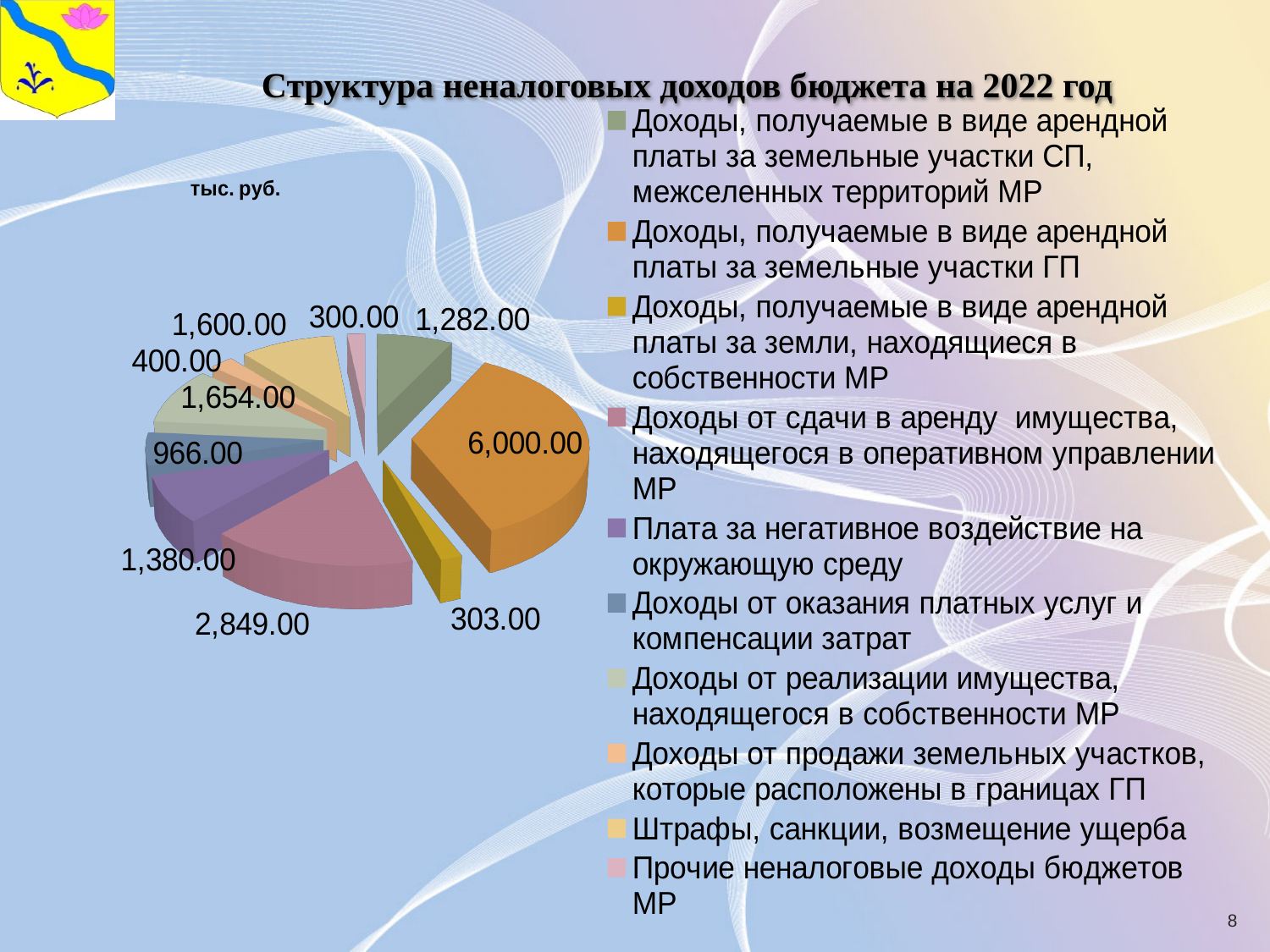
What is the title of the chart on the slide? Структура неналоговых доходов бюджета на 2022 год Which is larger: the value for 'Доходы от реализации имущества, находящегося в собственности МР' or the value for 'Доходы от оказания платных услуг и компенсации затрат'? Доходы от реализации имущества, находящегося в собственности МР What kind of chart is shown on the slide? pie chart Which category has the smallest slice of the pie? Прочие неналоговые доходы бюджетов МР What is the value for 'Доходы, получаемые в виде арендной платы за земельные участки ГП'? 6,000.00 What is the value for 'Плата за негативное воздействие на окружающую среду'? 1,380.00 What is the difference between the value for 'Доходы, получаемые в виде арендной платы за земельные участки ГП' and the value for 'Доходы от сдачи в аренду имущества, находящегося в оперативном управлении МР'? 3,151.00 What is the value for 'Штрафы, санкции, возмещение ущерба'? 1,600.00 How many slices does the pie chart have? 10 How many entries does the legend list? 10 Which category has the largest slice of the pie? Доходы, получаемые в виде арендной платы за земельные участки ГП What is the value for 'Доходы от сдачи в аренду имущества, находящегося в оперативном управлении МР'? 2,849.00